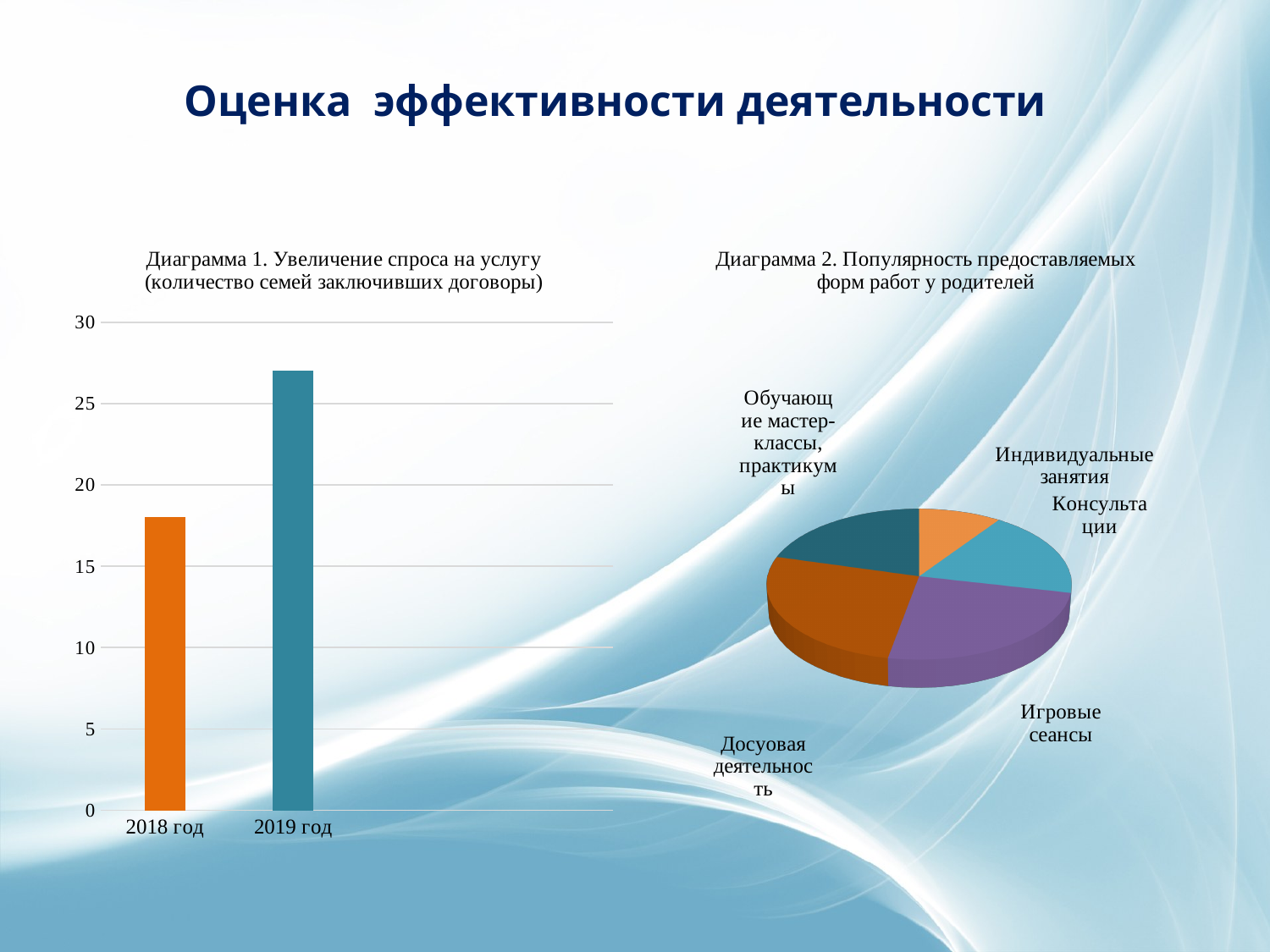
In Диаграмма 2, which category has the smallest slice? Индивидуальные занятия In Диаграмма 1, is the value for 2018 год greater or less than 15? greater In Диаграмма 1, is the value for 2018 год greater or less than 20? less In Диаграмма 2, how many slices does the pie have? 5 In Диаграмма 1, is the value for 2019 год greater or less than 30? less In Диаграмма 1, do the values rise or fall from 2018 год to 2019 год? rise In Диаграмма 1, how many categories are shown on the x axis? 2 In Диаграмма 1, which year has the higher bar? 2019 год In Диаграмма 2, which slice is larger: Игровые сеансы or Индивидуальные занятия? Игровые сеансы What kind of chart is Диаграмма 2 on the right of the slide? pie chart What kind of chart is Диаграмма 1 on the left of the slide? bar chart